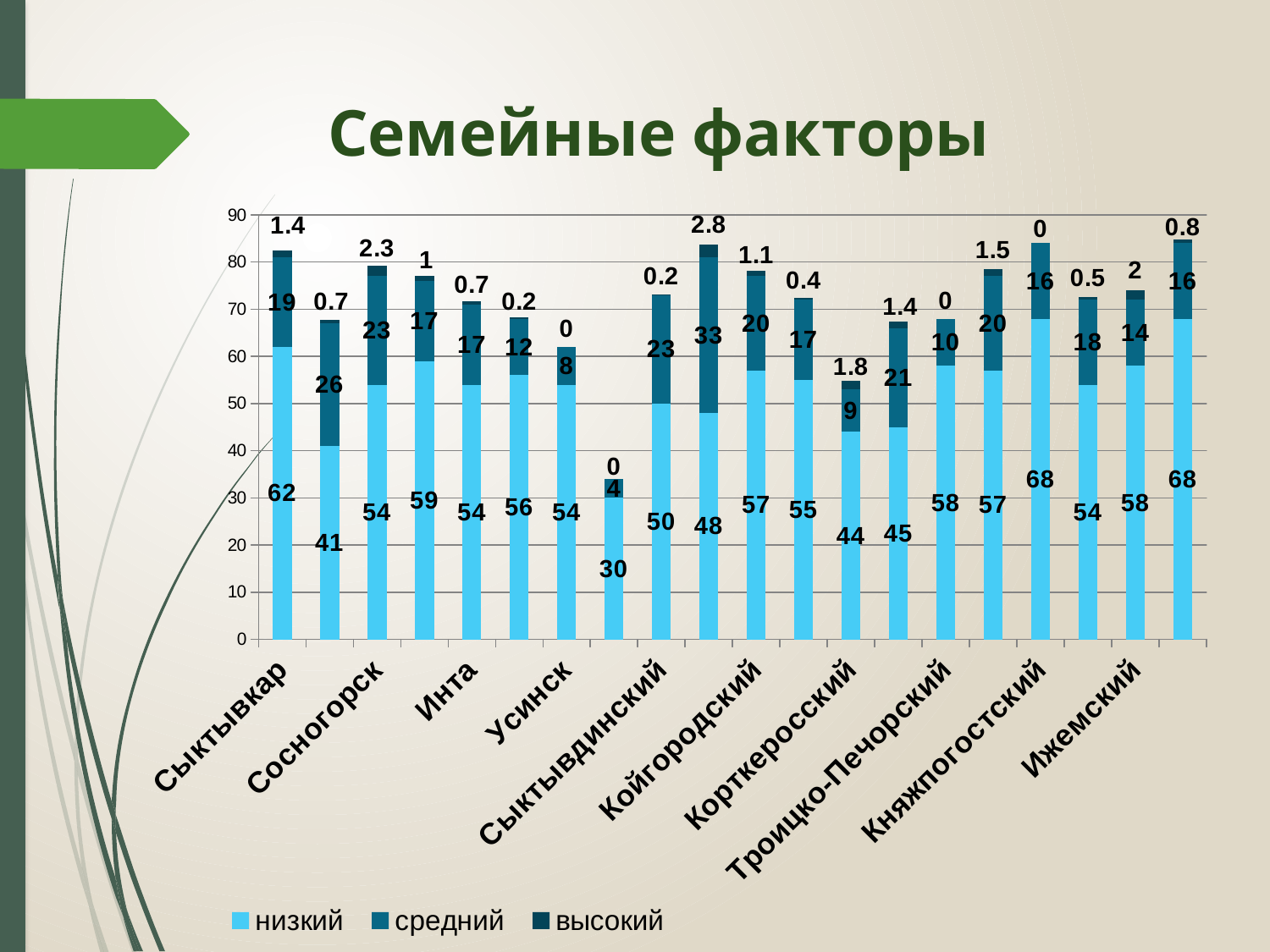
What is the total of the stacked bar for Сыктывкар? 82.4 What is the title of the chart? Семейные факторы What are the legend entries of the chart? низкий, средний, высокий Which has the larger 'низкий' value, Сыктывкар or Сосногорск? Сыктывкар What is the difference between the 'низкий' values for Сыктывкар and Сосногорск? 8 What is the value of the 'низкий' series for Сыктывкар? 62 How many stacked bars are plotted in the chart? 20 What is the value of the 'высокий' series for Корткеросский? 1.8 Is the 'низкий' value for Корткеросский greater or less than 50? less What kind of chart is shown on the slide? Stacked bar chart What is the value of the 'средний' series for Сосногорск? 23 How many series does the legend list? 3